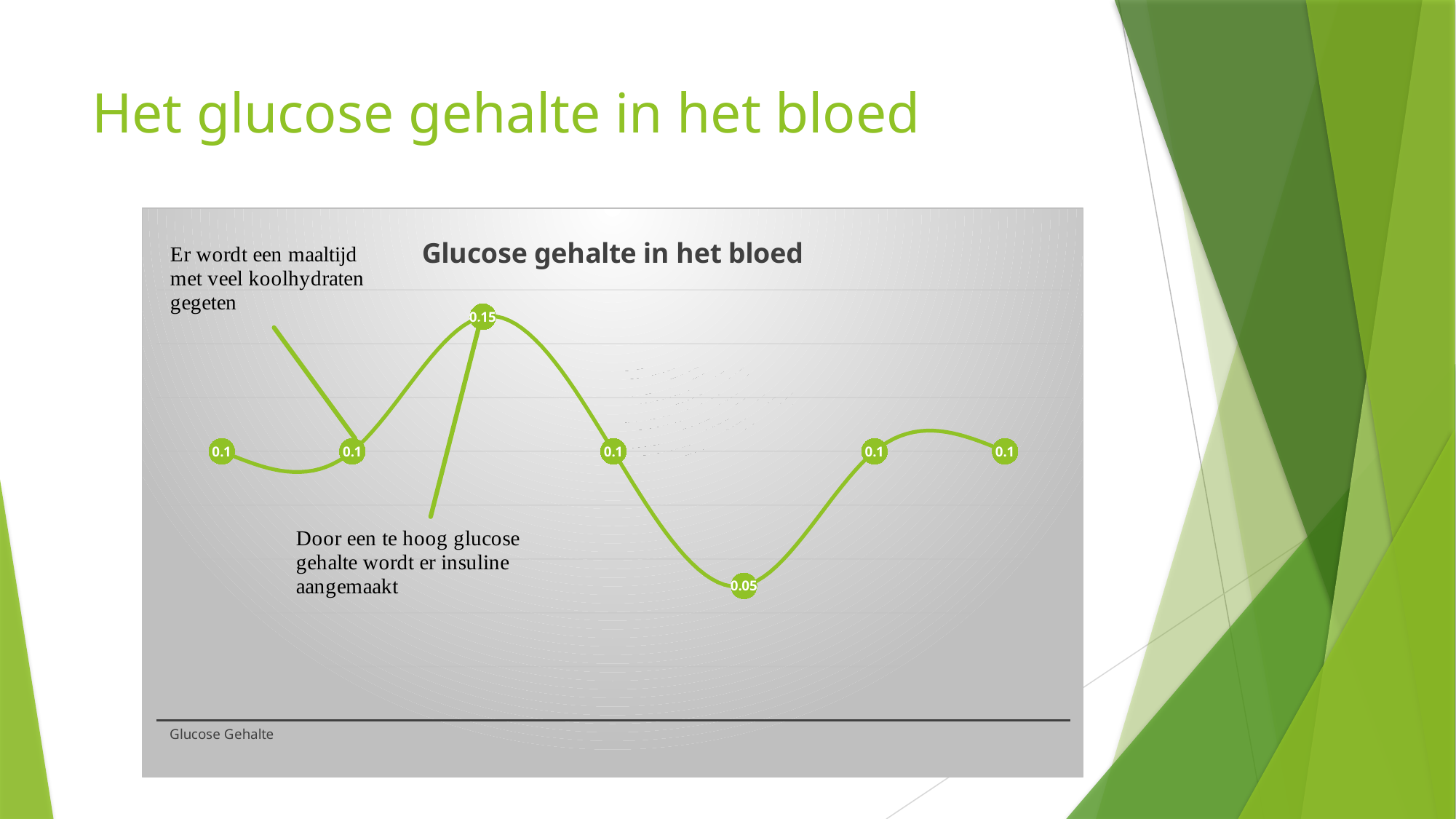
How many data points are plotted on the line? 7 What is the lowest value plotted on the line? 0.05 What is the value of the fifth data point from the left? 0.05 What is the difference between the highest and lowest plotted values? 0.1 What kind of chart is shown on the slide? line chart Which is larger, the third data point or the fifth data point? the third data point What is the highest value plotted on the line? 0.15 How many data points have the value 0.1? 5 What is the title of the chart? Glucose gehalte in het bloed What is the value of the third data point from the left? 0.15